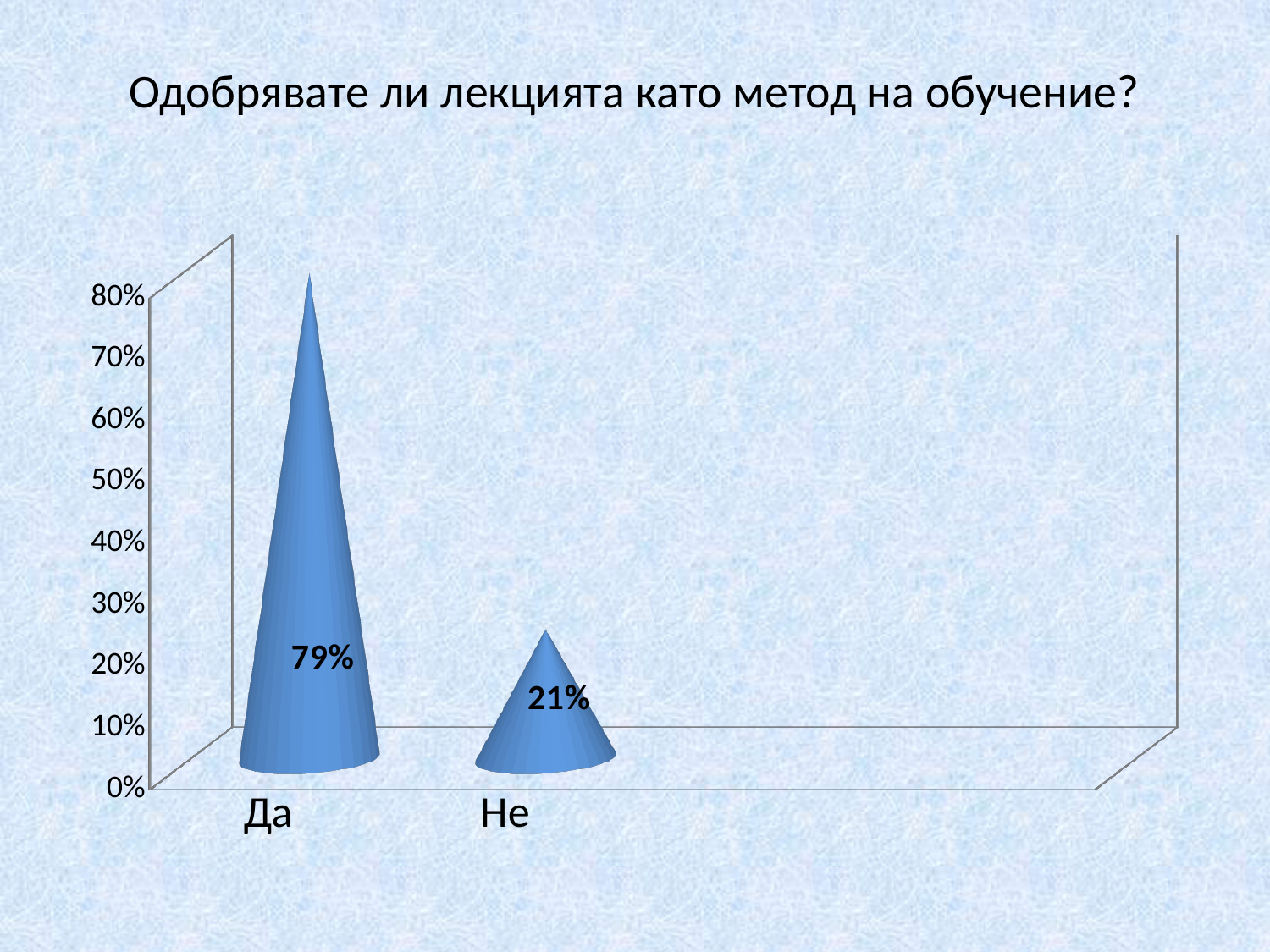
What is the difference between the values for Да and Не? 58% What is the title of the slide? Одобрявате ли лекцията като метод на обучение? Which is larger, the value for Да or the value for Не? Да Which category has the lowest value? Не Is the value for Да greater or less than 50%? greater How many categories are shown on the x axis? 2 What is the highest value labelled on the vertical axis? 80% What kind of chart is shown on the slide? bar chart What is the value for Не? 21% What is the value for Да? 79% Is the value for Не greater or less than 30%? less Which category has the highest value? Да